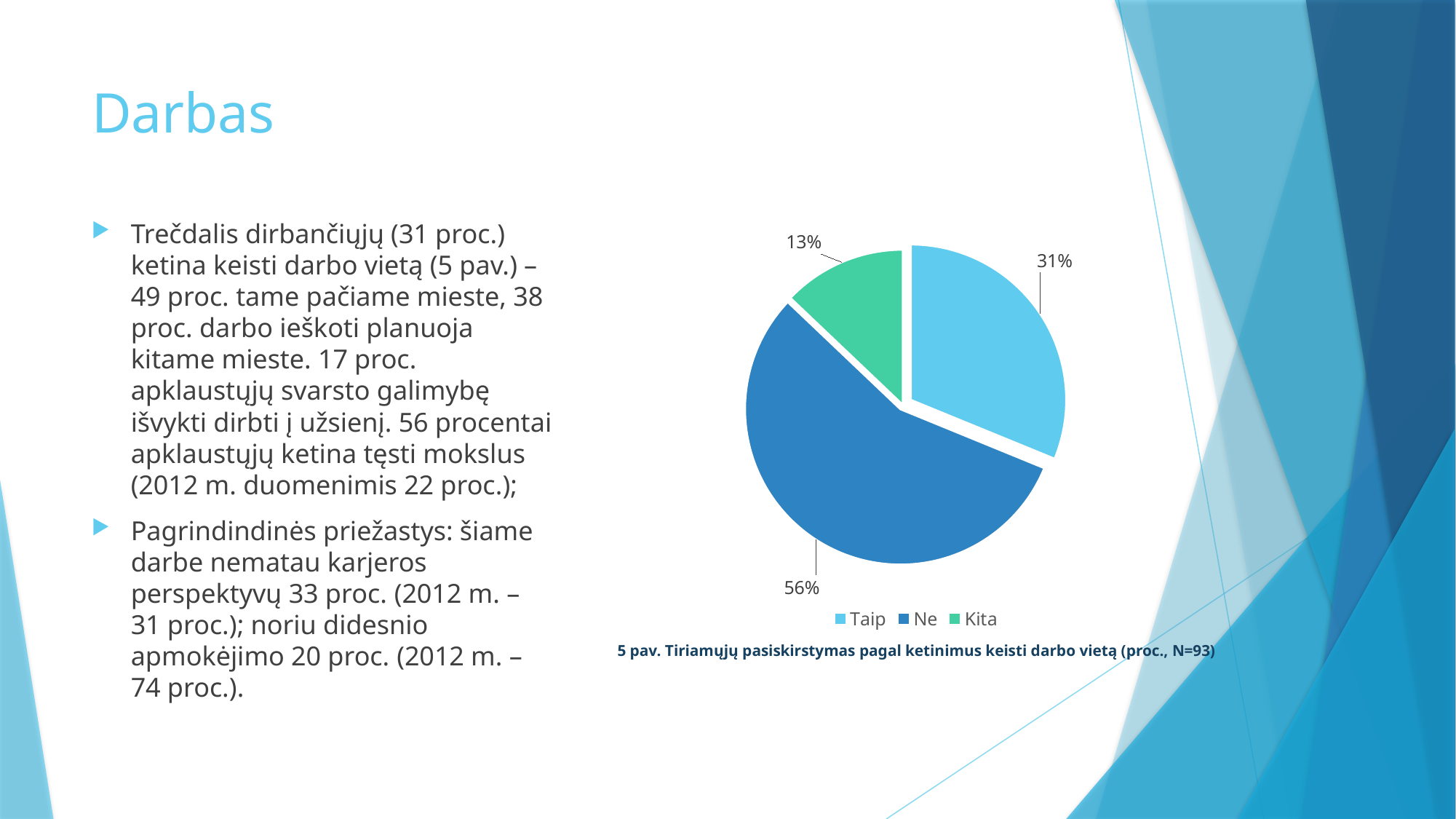
What is the value shown for the "Kita" slice? 13% What is the difference in percentage points between the "Ne" and "Taip" slices? 25 What kind of chart is shown on the slide? Pie chart What is the value shown for the "Ne" slice? 56% What share of the pie does the "Taip" slice represent? 31% Which category has the largest slice of the pie? Ne Which is larger, the "Taip" slice or the "Kita" slice? Taip What is the sample size (N) stated in the chart caption? 93 What colour is the "Kita" slice in the pie chart? Green Which category has the smallest slice of the pie? Kita How many entries does the legend list? 3 How many slices does the pie chart have? 3